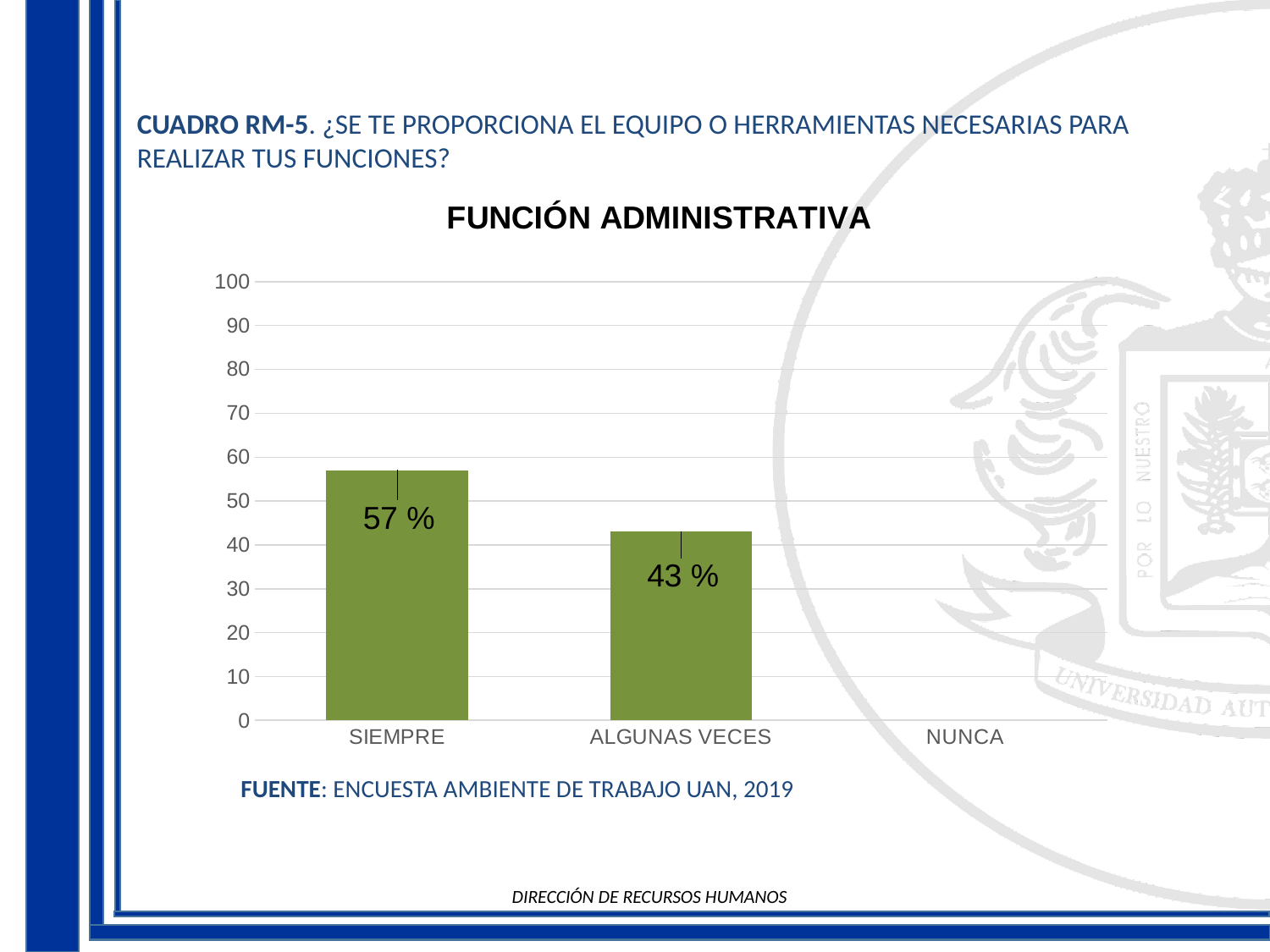
What is the title of the chart? FUNCIÓN ADMINISTRATIVA Do the values rise or fall from SIEMPRE to ALGUNAS VECES? fall How many categories are shown on the x axis? 3 What is the value for SIEMPRE? 57 % What is the value for ALGUNAS VECES? 43 % Which category has the highest value? SIEMPRE What kind of chart is shown on the slide? bar chart What is the difference between the values for SIEMPRE and ALGUNAS VECES? 14 % Is the value for SIEMPRE greater or less than 50? greater Which is larger, the value for SIEMPRE or the value for ALGUNAS VECES? SIEMPRE Is the value for ALGUNAS VECES greater or less than 50? less What is the highest value shown on the y axis? 100